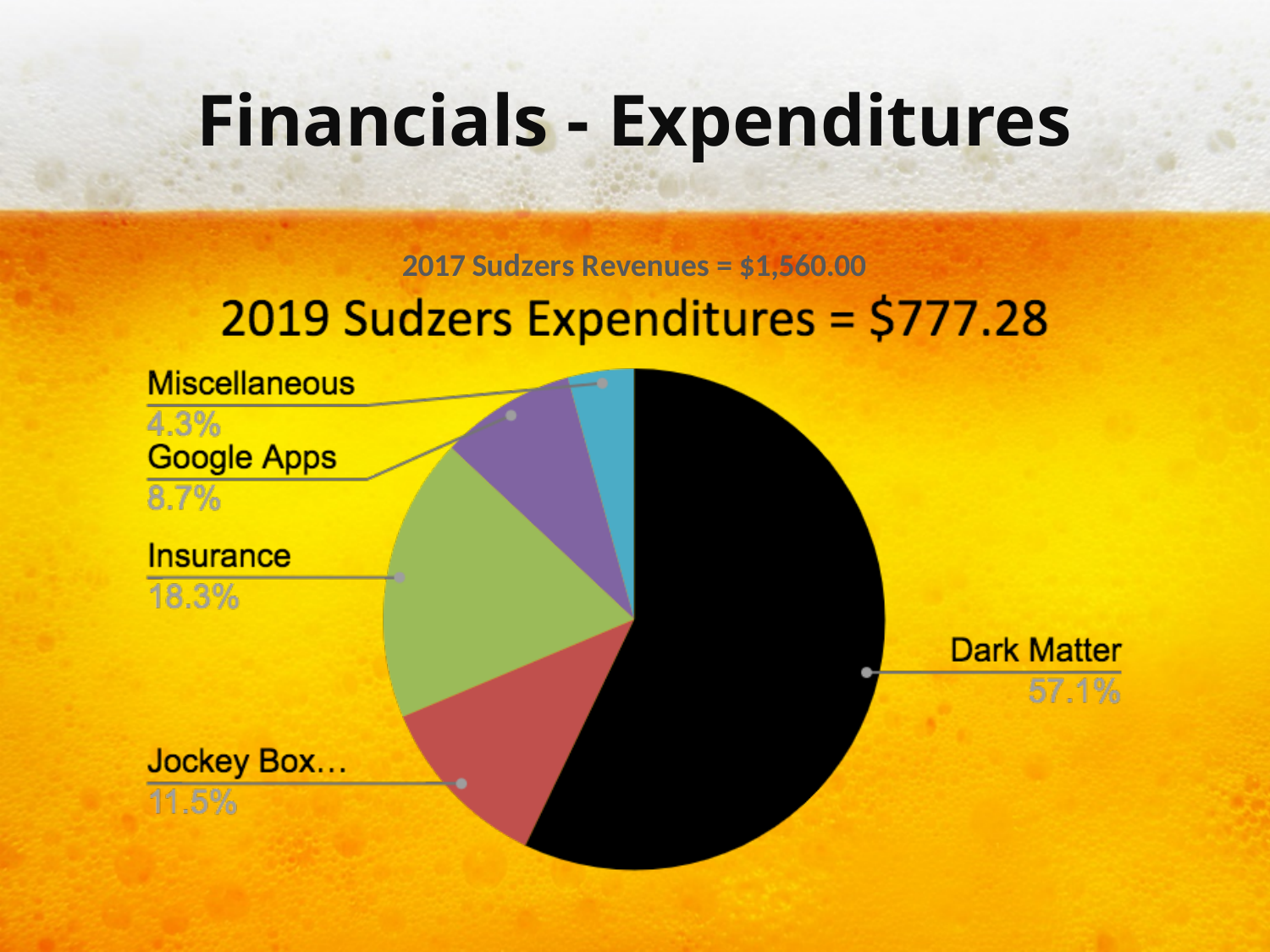
How many slices does the pie chart have? 5 Which category has the largest slice of the pie? Dark Matter What share of the pie is labelled Google Apps? 8.7% What percentage of expenditures is Insurance? 18.3% Which is larger, the Insurance slice or the Jockey Box slice? Insurance What kind of chart is shown on the slide? Pie chart What is the difference in percentage points between Dark Matter and Insurance? 38.8 What share of the pie does the Jockey Box slice represent? 11.5% What percentage is shown for Miscellaneous? 4.3% What total expenditure amount is stated in the chart title? $777.28 Which category has the smallest slice of the pie? Miscellaneous What share of the pie does Dark Matter represent? 57.1%